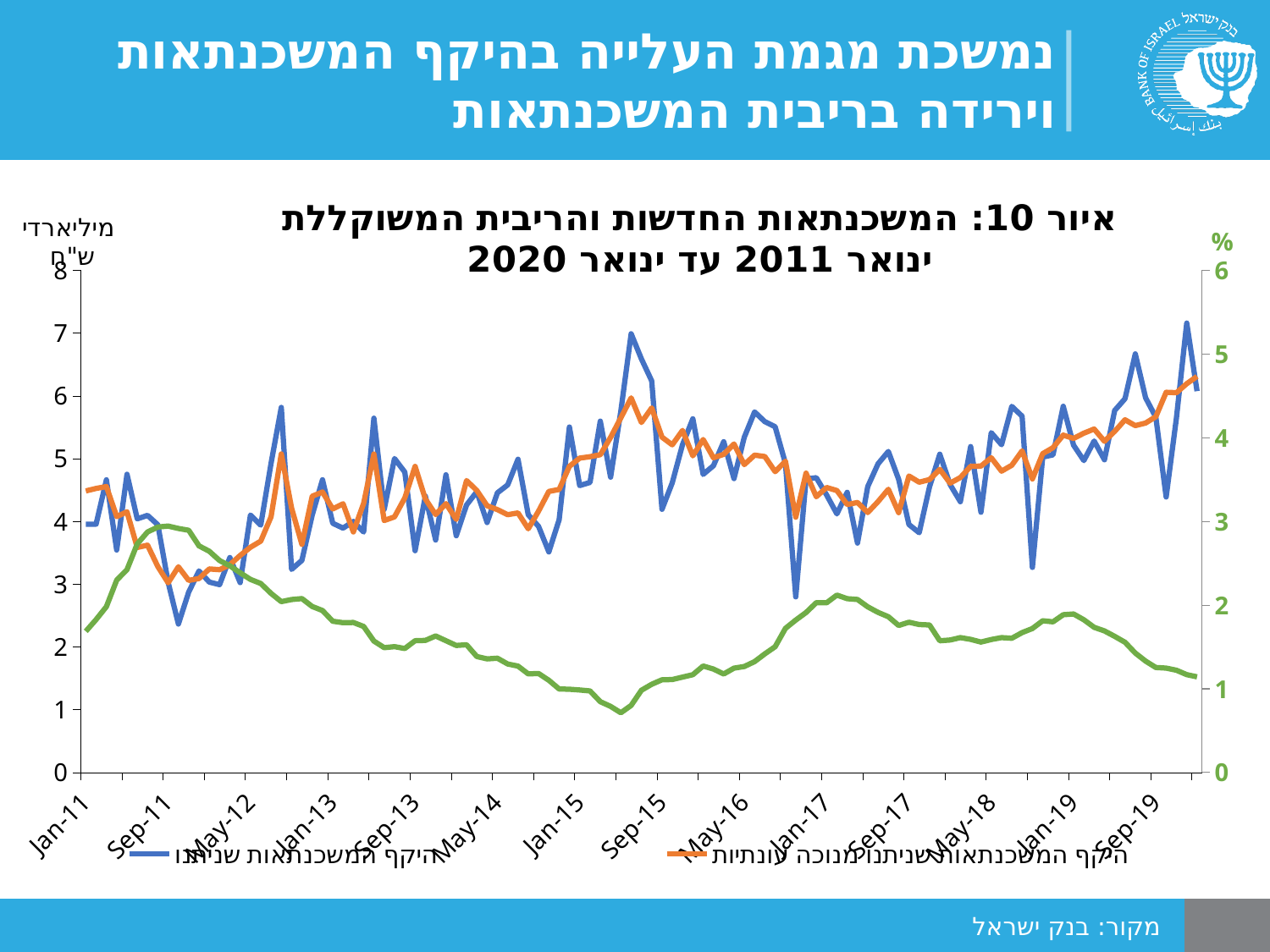
Is the value of the orange line (היקף המשכנתאות שניתנו מנוכה עונתיות) at the end of the series greater or less than 6? greater Is the value of the green line at its lowest point around mid-2015 greater or less than 1 on the right axis? less Does the green line overall rise or fall from its peak in late 2011 to the end of the series in 2020? fall What kind of chart is shown on the slide? line chart Does the orange line (היקף המשכנתאות שניתנו מנוכה עונתיות) overall rise or fall from Jan-11 to Jan-20? rise What unit is shown on the left vertical axis of the chart? מיליארדי ש"ח What is the title of the chart? איור 10: המשכנתאות החדשות והריבית המשוקללת ינואר 2011 עד ינואר 2020 How many date labels are shown on the x axis? 14 Which is larger for the blue line: the value at Jan-11 or the value at the end of the series around Jan-20? Jan-20 Is the value of the blue line (היקף המשכנתאות שניתנו) at its peak around Sep-15 greater or less than 6? greater